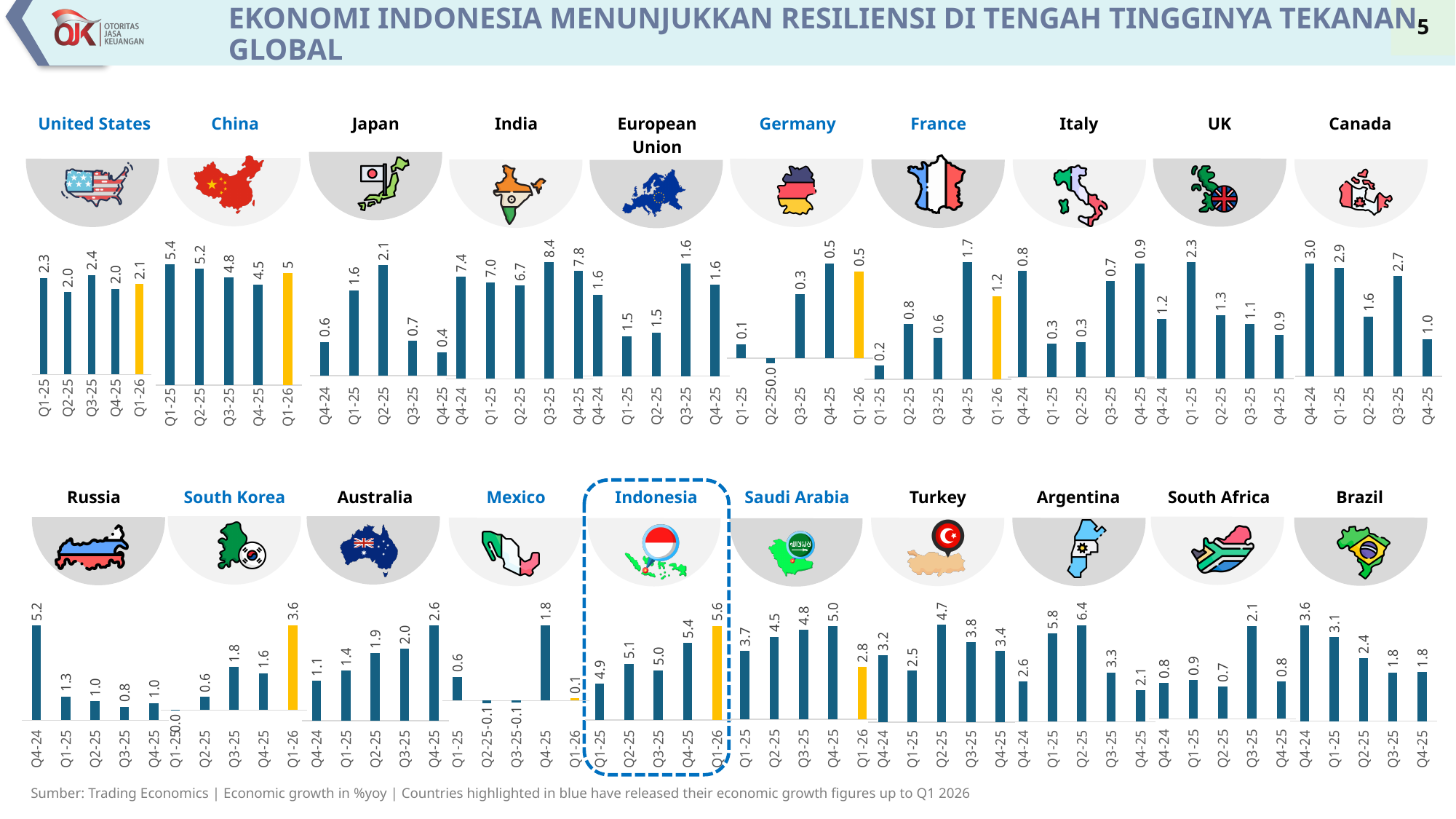
In the Indonesia chart, do the values rise or fall from Q3-25 to Q1-26? rise In the Canada chart, which is larger, the value for Q4-24 or the value for Q4-25? Q4-24 In the South Korea chart, what is the value for Q1-26? 3.6 In the China chart, what is the value for Q1-25? 5.4 In the India chart, which quarter has the highest value? Q3-25 What type of chart is used for each country on the slide? bar chart In the Saudi Arabia chart, what is the difference between the Q4-25 value and the Q1-26 value? 2.2 In the Russia chart, which quarter has the lowest value? Q3-25 In the Indonesia chart, what is the economic growth value for Q1-26? 5.6 In the Mexico chart, what is the value for Q4-25? 1.8 How many quarters are plotted in the United States chart? 5 In the Argentina chart, what is the difference between the Q2-25 value and the Q4-25 value? 4.3